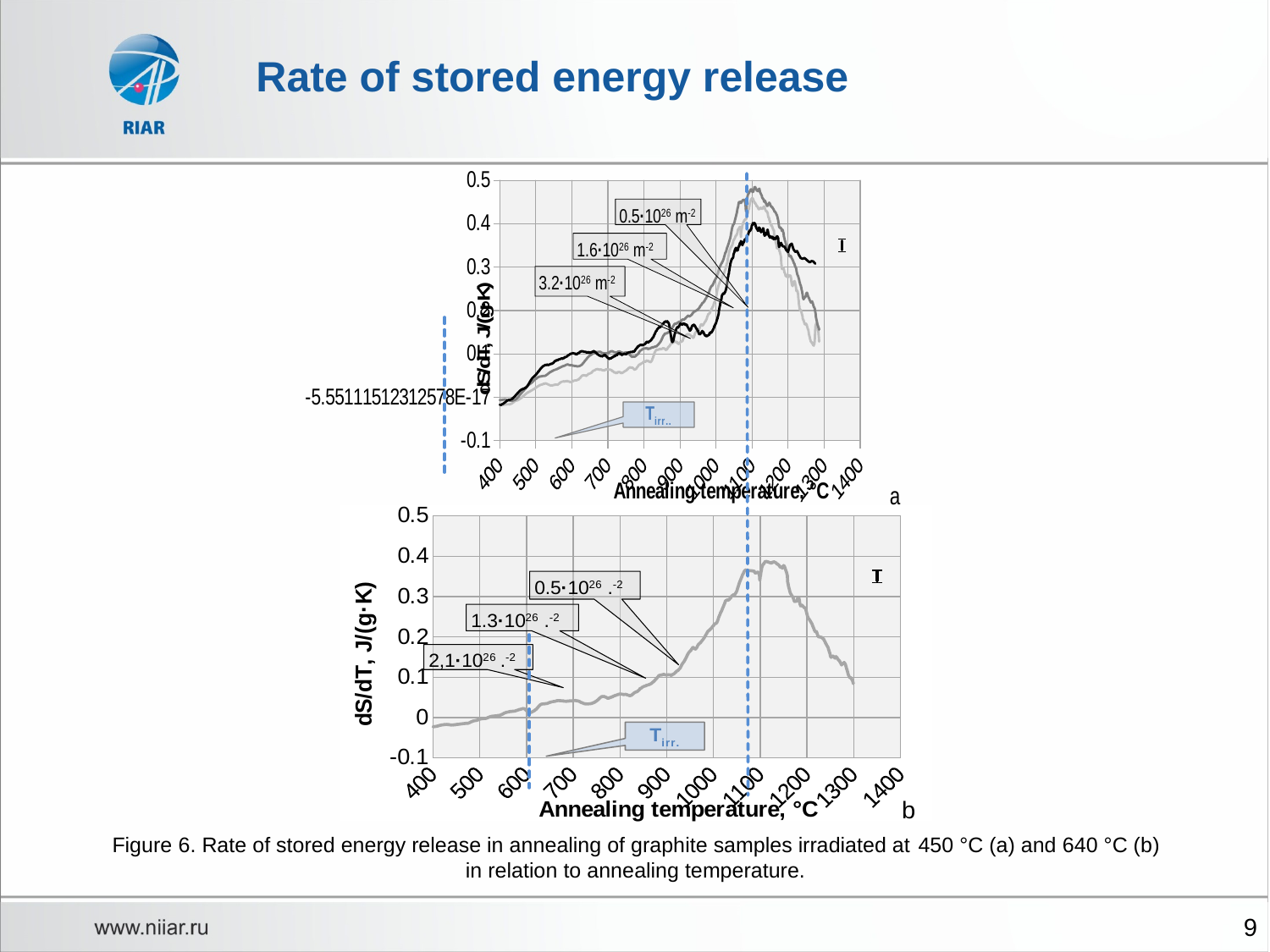
What is the y-axis label of chart (b), the lower chart? dS/dT, J/(g·K) What is the x-axis label of chart (b), the lower chart? Annealing temperature, °C What kind of chart is chart (a), the upper chart on the slide? Line chart In chart (b), the lower chart, is the peak value of the curves greater or less than 0.3? greater In chart (b), the lower chart, is the value of the curves at 1300 °C greater or less than 0.2? less In chart (b), the lower chart, is the value of the curves at 400 °C greater or less than 0.1? less How many curves are plotted in chart (a), the upper chart? 3 How many curves are plotted in chart (b), the lower chart? 3 In chart (a), the upper chart, do the curves rise or fall between 1100 °C and 1300 °C? fall What is the highest value shown on the y axis of chart (b), the lower chart? 0.5 In chart (b), the lower chart, do the curves generally rise or fall between 400 °C and 1100 °C? rise